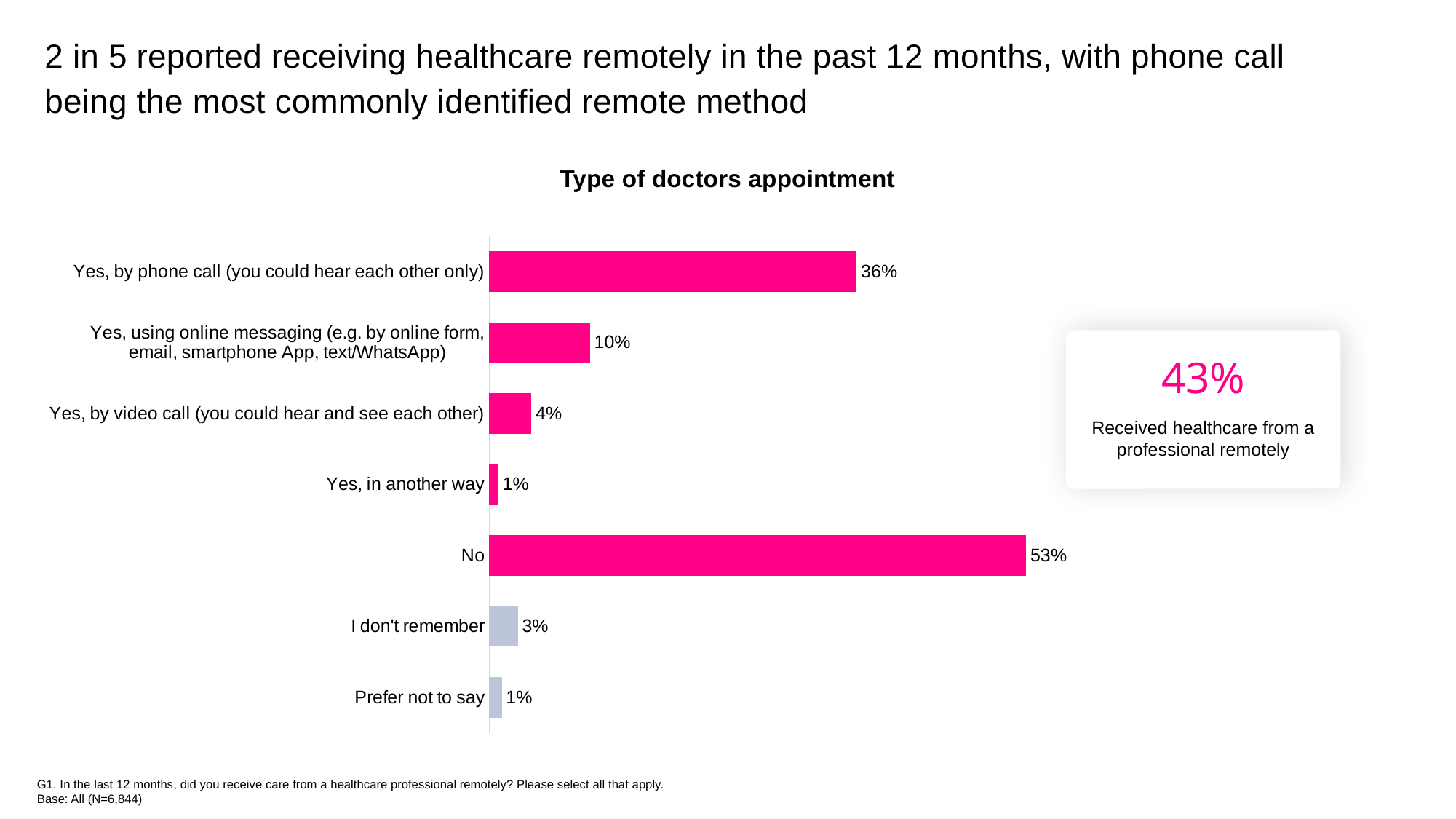
How many categories are shown in the chart? 7 What is the difference between the values for "No" and "Yes, by phone call (you could hear each other only)"? 17% What kind of chart is shown on the slide? Bar chart What is the value for "No"? 53% What is the value for "I don't remember"? 3% What is the value for "Yes, by video call (you could hear and see each other)"? 4% Which is larger: the value for "Yes, using online messaging" or the value for "I don't remember"? Yes, using online messaging What is the value for "Yes, by phone call (you could hear each other only)"? 36% What is the difference between the values for "Yes, using online messaging" and "Yes, by video call"? 6% Which category has the highest value? No What percentage is shown in the callout box to the right of the chart? 43% What is the title of the chart? Type of doctors appointment